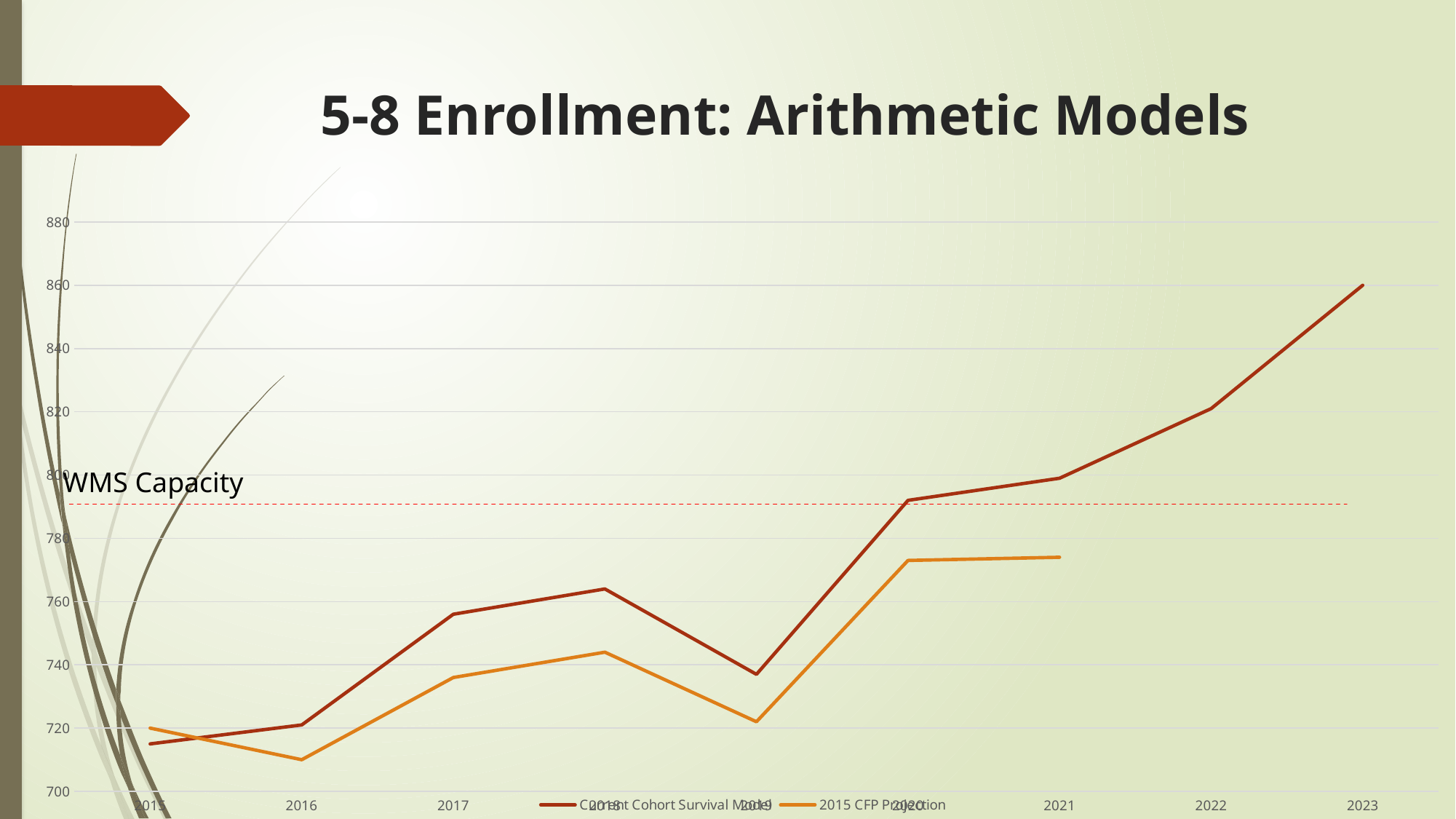
In 2020, which series has the higher value, the Current Cohort Survival Model or the 2015 CFP Projection? Current Cohort Survival Model In which year is the 2015 CFP Projection at its lowest value? 2016 In which year is the Current Cohort Survival Model at its lowest value? 2015 Does the Current Cohort Survival Model rise or fall from 2019 to 2023? rise In which year does the Current Cohort Survival Model reach its highest value? 2023 What kind of chart is shown on the slide? line chart How many years are shown along the x axis? 9 Is the value for the 2015 CFP Projection in 2020 greater or less than 780? less What is the title of the chart? 5-8 Enrollment: Arithmetic Models How many series does the legend list? 2 What does the horizontal dashed red line represent? WMS Capacity Is the value for the Current Cohort Survival Model in 2023 greater or less than 840? greater